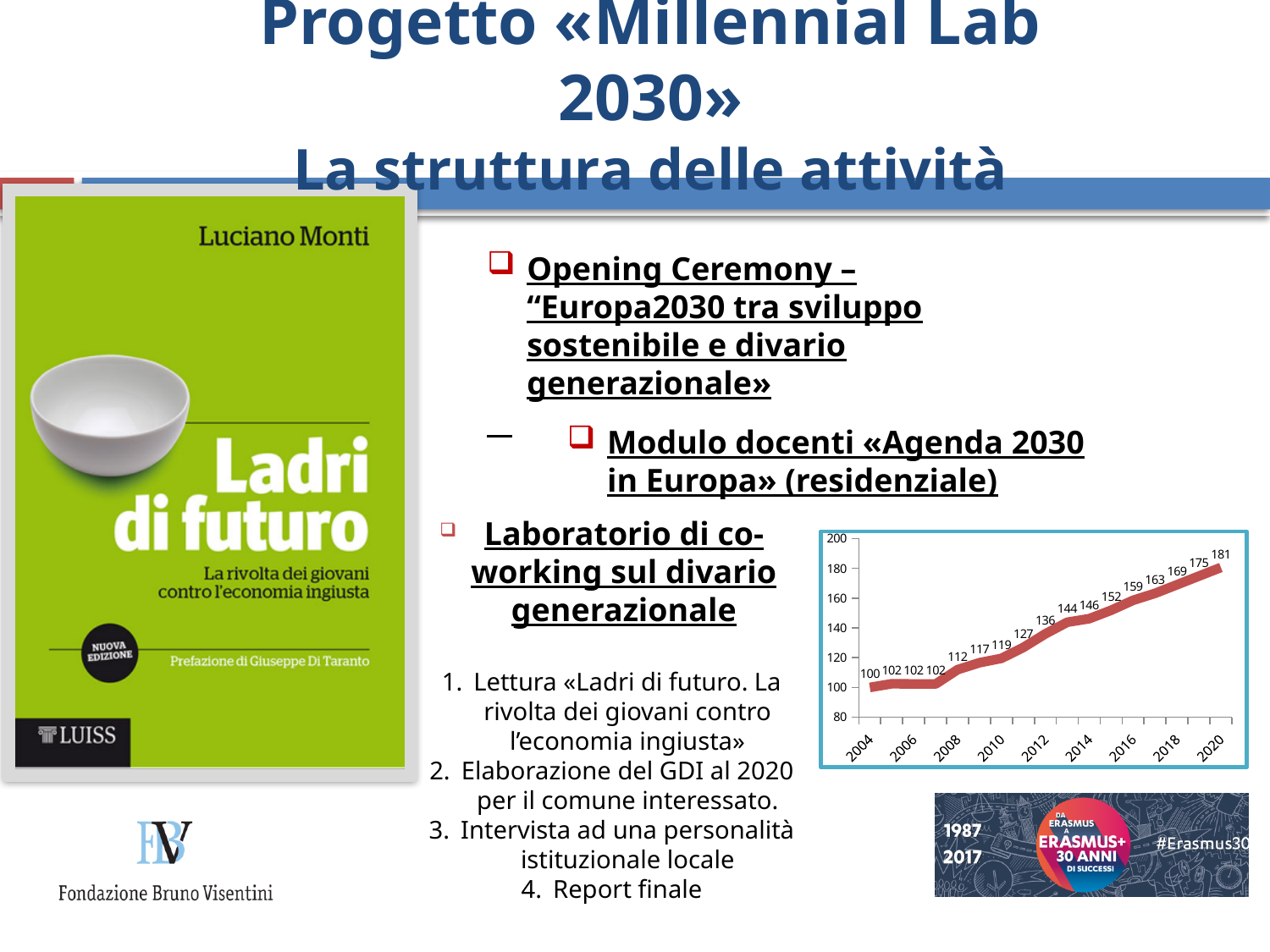
How many data points are plotted on the line? 17 What is the value plotted for 2020? 181 What is the value plotted for 2008? 112 Which year has the highest value on the chart? 2020 Which is larger, the value for 2016 or the value for 2012? 2016 What kind of chart is shown on the slide? line chart Is the value for 2020 greater or less than 160? greater What is the value plotted for 2004? 100 What is the difference between the values for 2020 and 2004? 81 Which year has the lowest value on the chart? 2004 What is the value plotted for 2012? 136 Do the values rise or fall from 2004 to 2020? rise